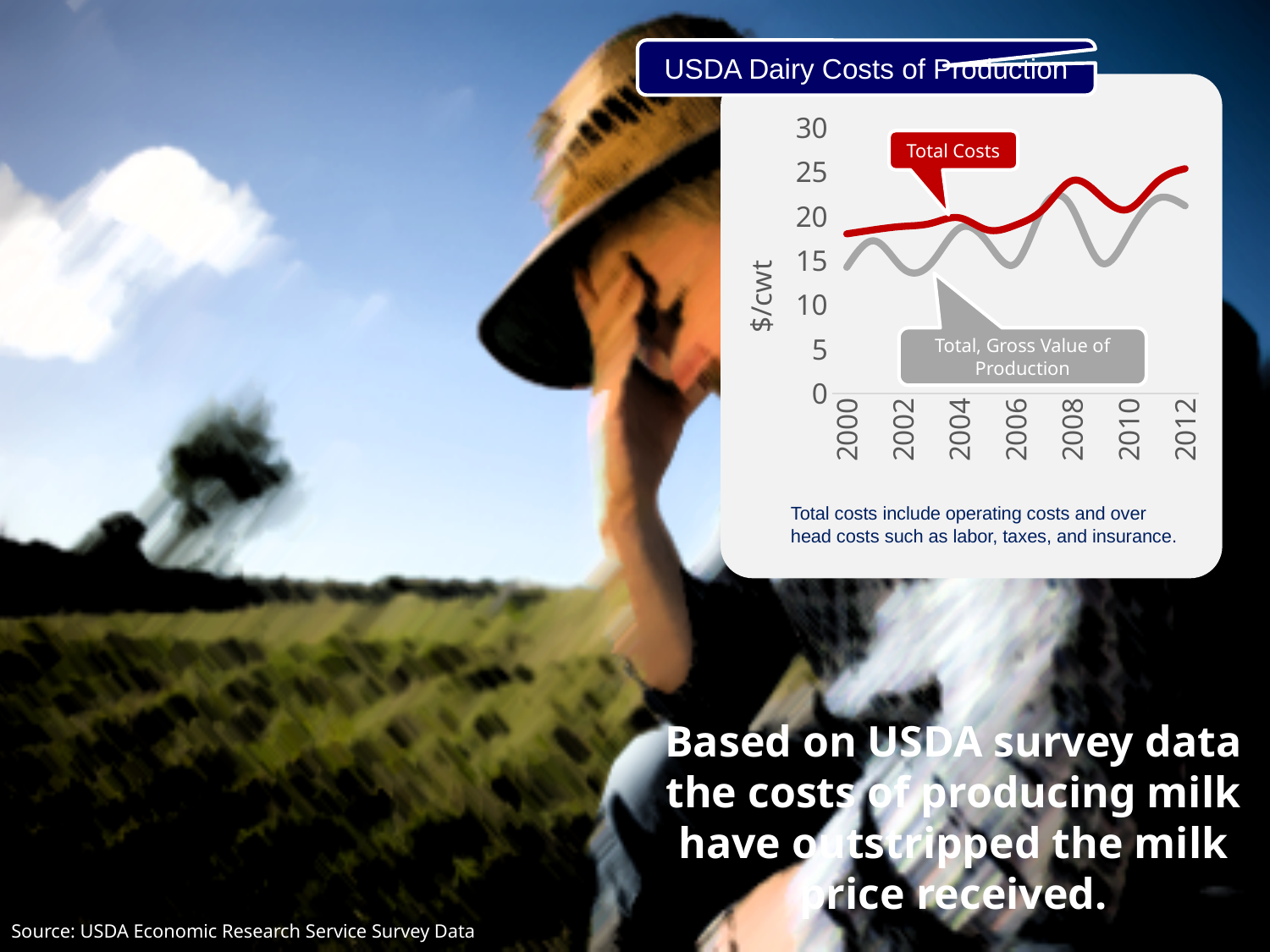
How many series are plotted on the chart? 2 How many year labels are shown on the x axis? 7 What kind of chart is shown on the slide? line chart Is the Total Costs value in 2012 greater or less than 20? greater Is the Total, Gross Value of Production value in 2002 greater or less than 20? less What is the title of the chart? USDA Dairy Costs of Production Is the Total Costs value in 2000 greater or less than 20? less Which series reaches the highest value shown on the chart? Total Costs What is the label on the y axis of the chart? $/cwt Does the Total Costs line rise or fall overall from 2000 to 2012? rise In 2012, which series is higher: Total Costs or Total, Gross Value of Production? Total Costs